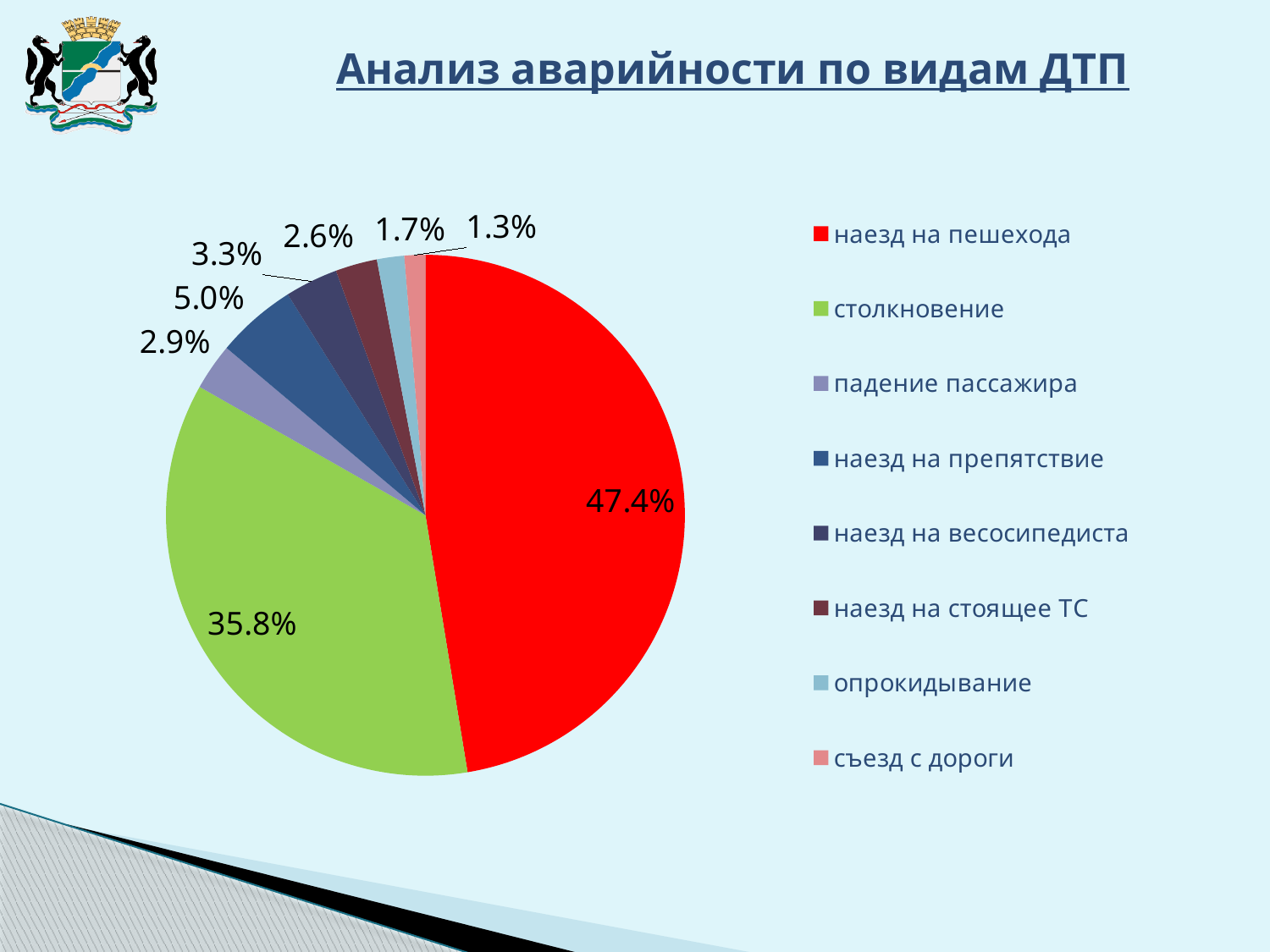
What is the value for "съезд с дороги"? 1.3% Which is larger, the share for "падение пассажира" or the share for "наезд на стоящее ТС"? падение пассажира What is the value for "наезд на препятствие"? 5.0% What share of the pie does "наезд на пешехода" have? 47.4% What is the value for "наезд на весосипедиста"? 3.3% What is the title of the chart on the slide? Анализ аварийности по видам ДТП How many categories does the legend of the pie chart list? 8 What kind of chart is shown on the slide? pie chart Which category has the smallest share of the pie? съезд с дороги Which category has the largest share of the pie? наезд на пешехода What share of the pie does "столкновение" have? 35.8% What is the difference between the shares of "наезд на пешехода" and "столкновение"? 11.6%